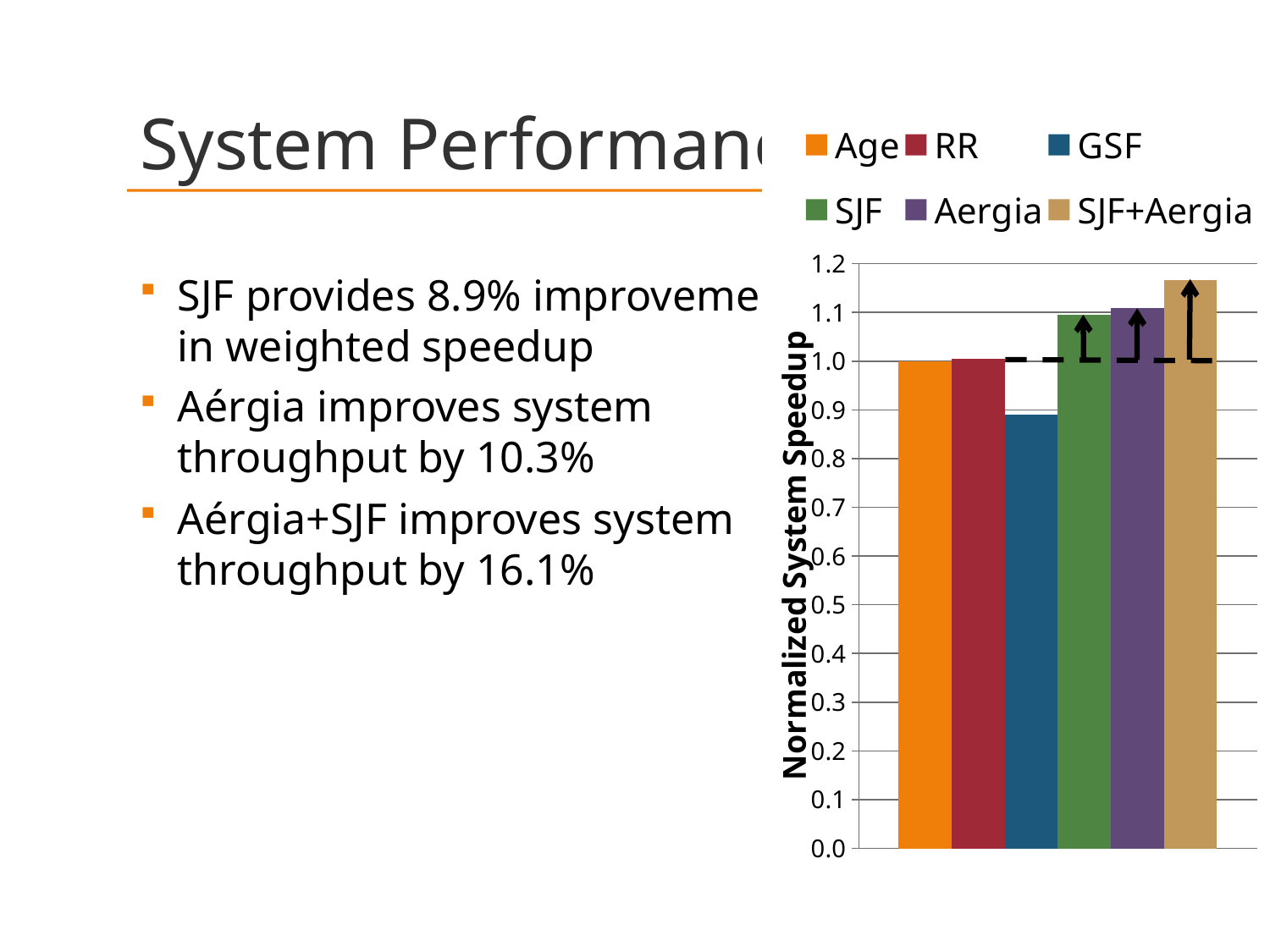
Is the normalized system speedup for SJF greater or less than 1.0? greater Which series has the lowest normalized system speedup? GSF Which series has the highest normalized system speedup? SJF+Aergia Which has a higher normalized system speedup, SJF or RR? SJF Is the normalized system speedup for GSF greater or less than 1.0? less How many series does the chart legend list? 6 What colour represents GSF in the chart legend? blue Is the normalized system speedup for SJF+Aergia greater or less than 1.2? less What kind of chart is shown on the slide? bar chart What is the normalized system speedup for Age? 1.0 What is the title of the vertical axis of the chart? Normalized System Speedup